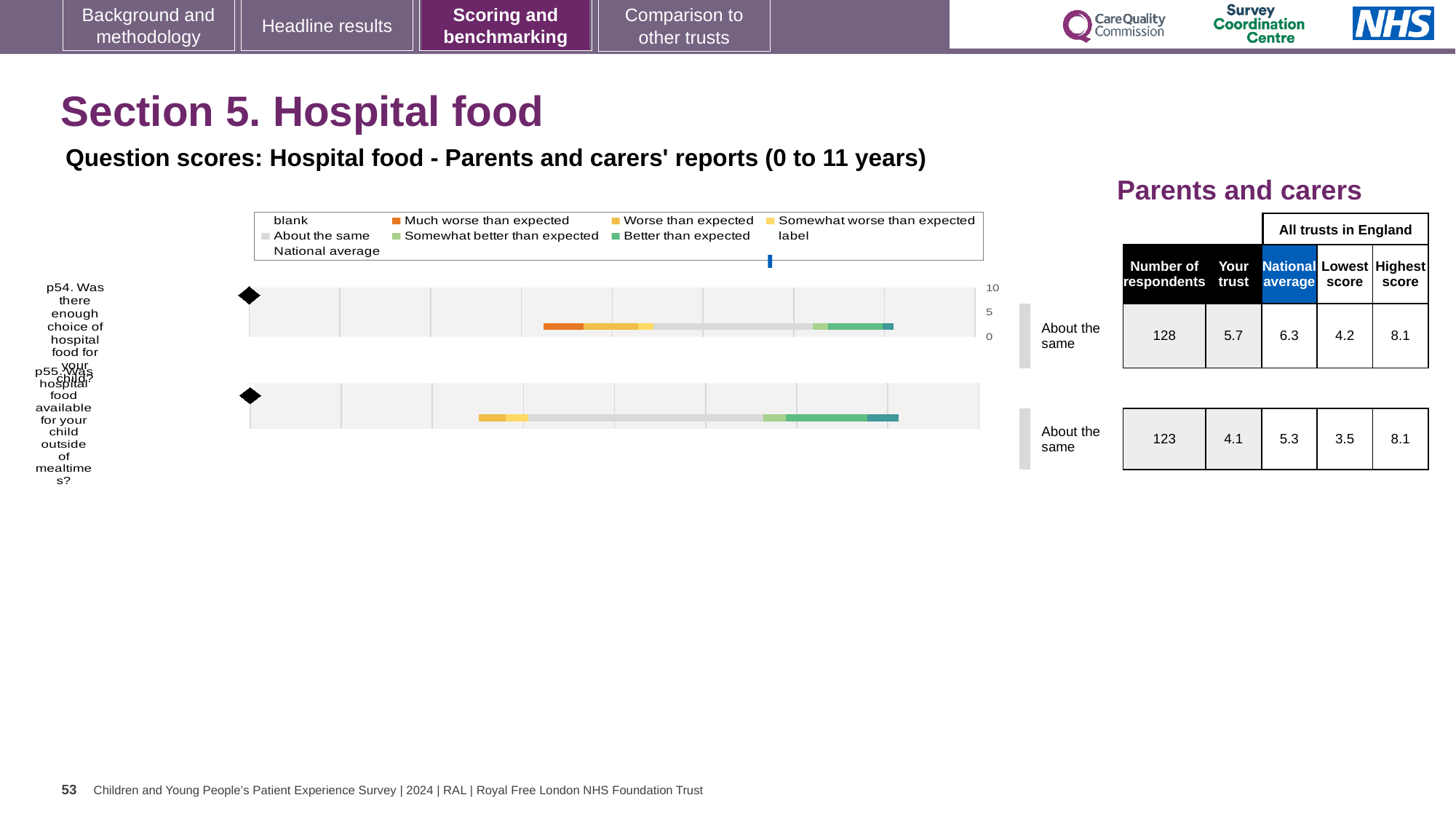
How many survey questions are plotted in the chart? 2 What is the difference between the national average and the trust's score for p54? 0.6 How many respondents answered p54? 128 What is the lowest score across all trusts in England for p55? 3.5 What is the 'Your trust' score for p54 (enough choice of hospital food)? 5.7 What is the 'Your trust' score for p55 (hospital food available outside of mealtimes)? 4.1 Which question has the higher 'Your trust' score, p54 or p55? p54 What is the national average score for p55 (hospital food available outside of mealtimes)? 5.3 What kind of chart is shown on the slide? bar chart What benchmark category is the trust rated for both p54 and p55? About the same What is the national average score for p54 (enough choice of hospital food)? 6.3 What is the difference between the national average and the trust's score for p55? 1.2